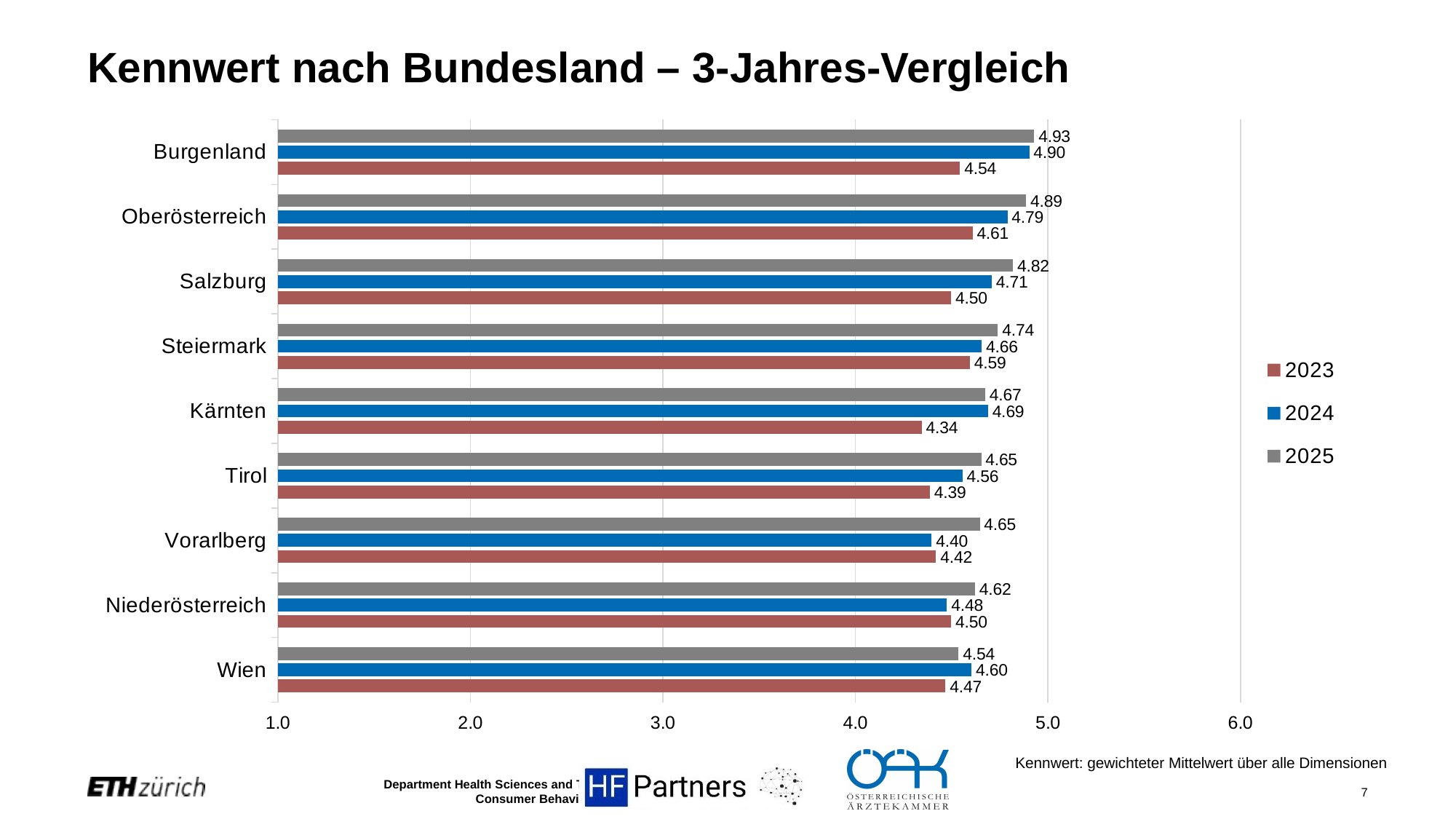
Which is larger for Wien: the 2024 value or the 2025 value? 2024 Is the 2024 value for Oberösterreich greater or less than 4.0? greater What is the 2024 value for Vorarlberg? 4.40 What is the 2023 value for Kärnten? 4.34 What kind of chart is shown on the slide? bar chart How many Bundesländer are shown on the chart? 9 Which Bundesland has the lowest 2023 value? Kärnten Which Bundesland has the highest 2025 value? Burgenland What is the difference between the 2025 and 2023 values for Burgenland? 0.39 What is the 2025 value for Burgenland? 4.93 Which colour represents the year 2024 in the chart? blue How many series does the legend list? 3